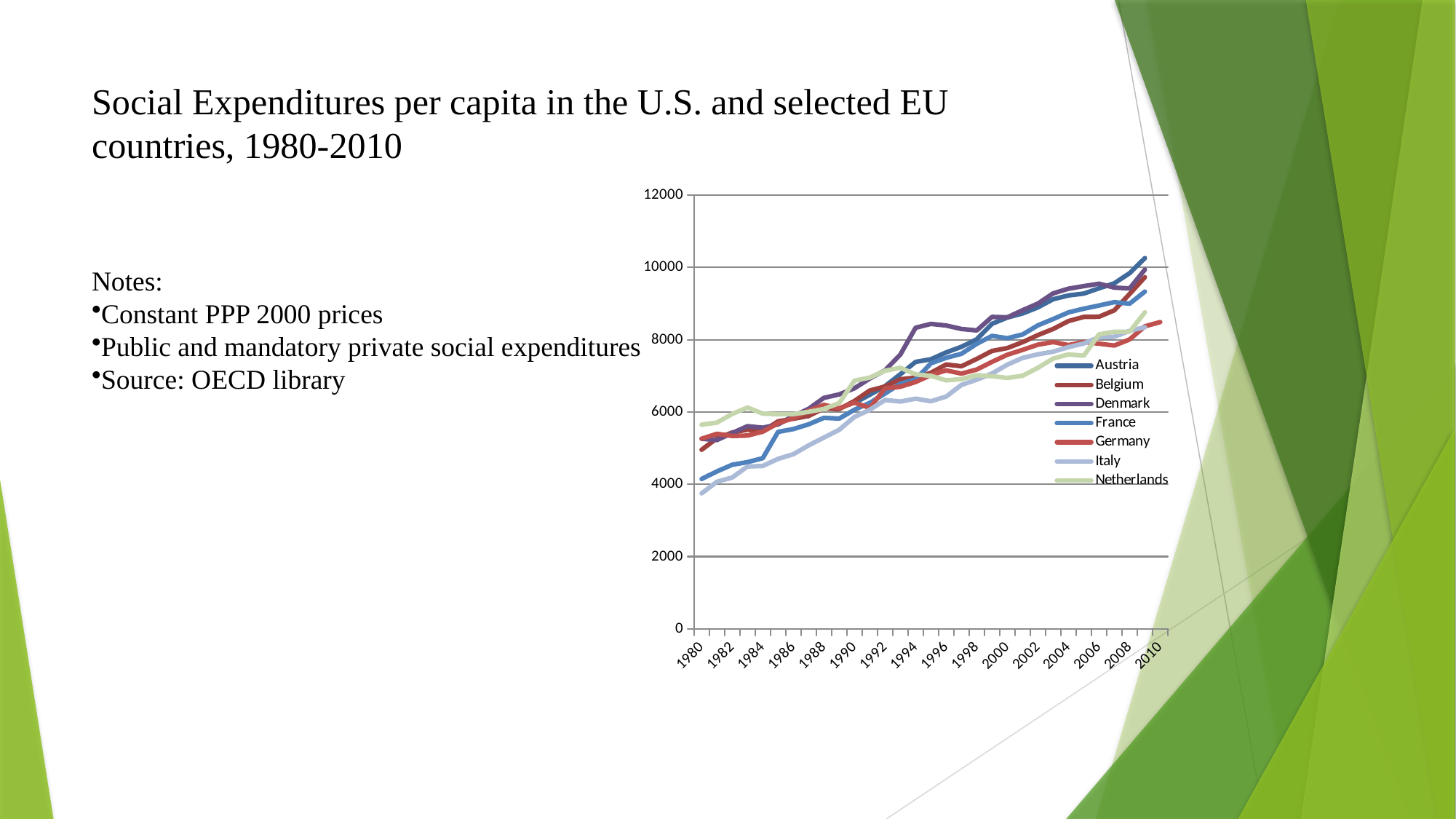
Is the value for Netherlands in 1980 greater or less than 4000? greater What is the title of the slide containing the chart? Social Expenditures per capita in the U.S. and selected EU countries, 1980-2010 Which country has the lowest social expenditure per capita in 1980? Italy Is the value for Italy in 1980 greater or less than 4000? less What is the highest value shown on the vertical axis? 12000 Which country has the highest social expenditure per capita in 1980? Netherlands Is the value for Denmark in 1995 greater or less than 8000? greater What kind of chart is shown on the slide? line chart In 1980, which is larger: the value for Netherlands or the value for Italy? Netherlands How many series does the chart's legend list? 7 Do the social expenditure values generally rise or fall from 1980 to 2010? rise